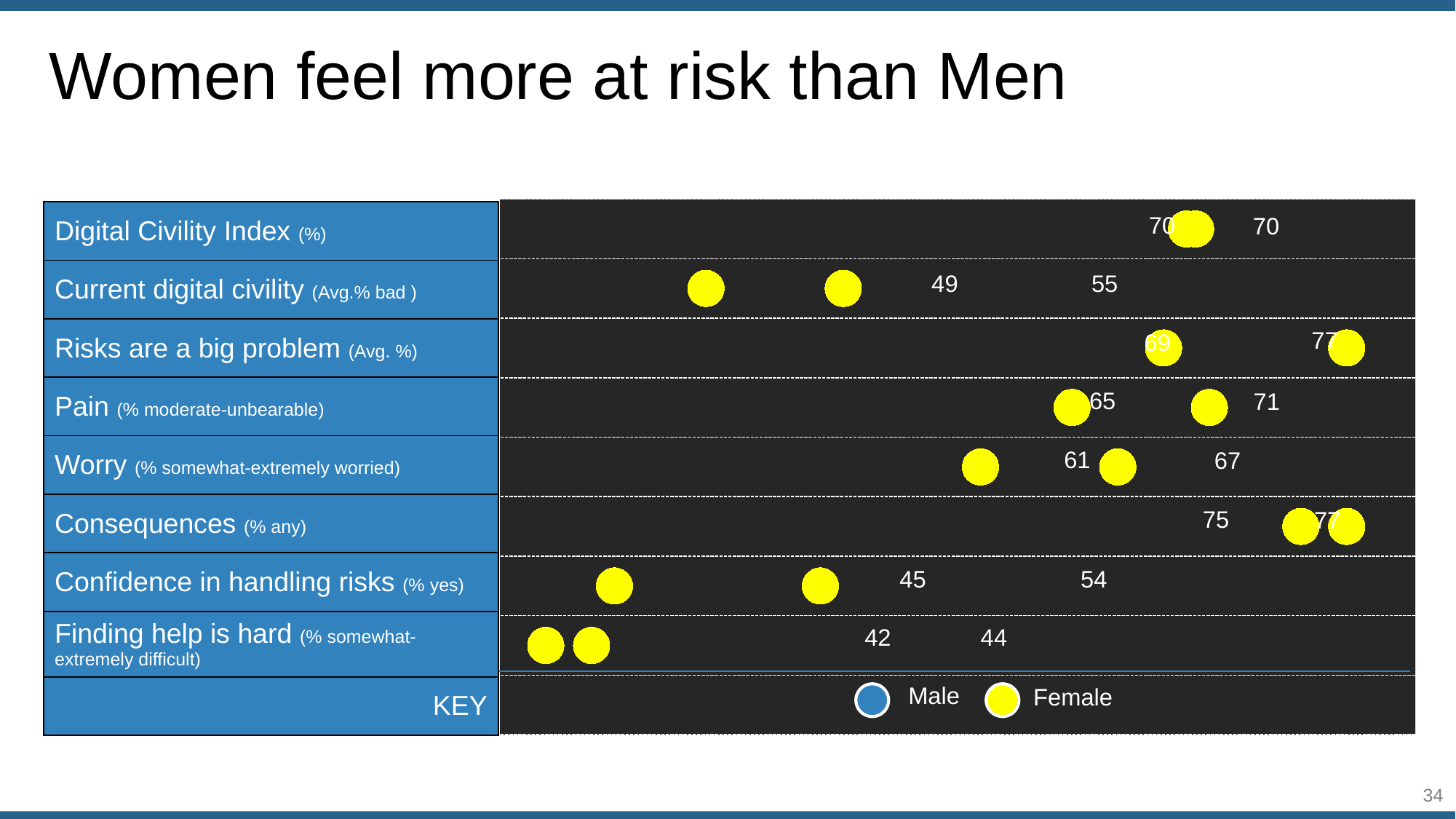
What is the difference between the two values printed for the Risks are a big problem row? 8 What two values are printed for the Pain (% moderate-unbearable) row? 65 and 71 What two values are printed for the Confidence in handling risks (% yes) row? 45 and 54 How many measure rows (excluding the KEY row) does the chart show? 8 What two values are printed for the Digital Civility Index (%) row? 70 and 70 What is the difference between the two values printed for the Confidence in handling risks row? 9 What is the smaller of the two values printed for the Finding help is hard row? 42 What are the two groups named in the KEY? Male and Female Which row contains the lowest printed value on the chart? Finding help is hard What is the larger of the two values printed for the Worry (% somewhat-extremely worried) row? 67 How many groups does the KEY list? 2 Is the larger value in the Consequences (% any) row greater than the larger value in the Current digital civility row? Yes